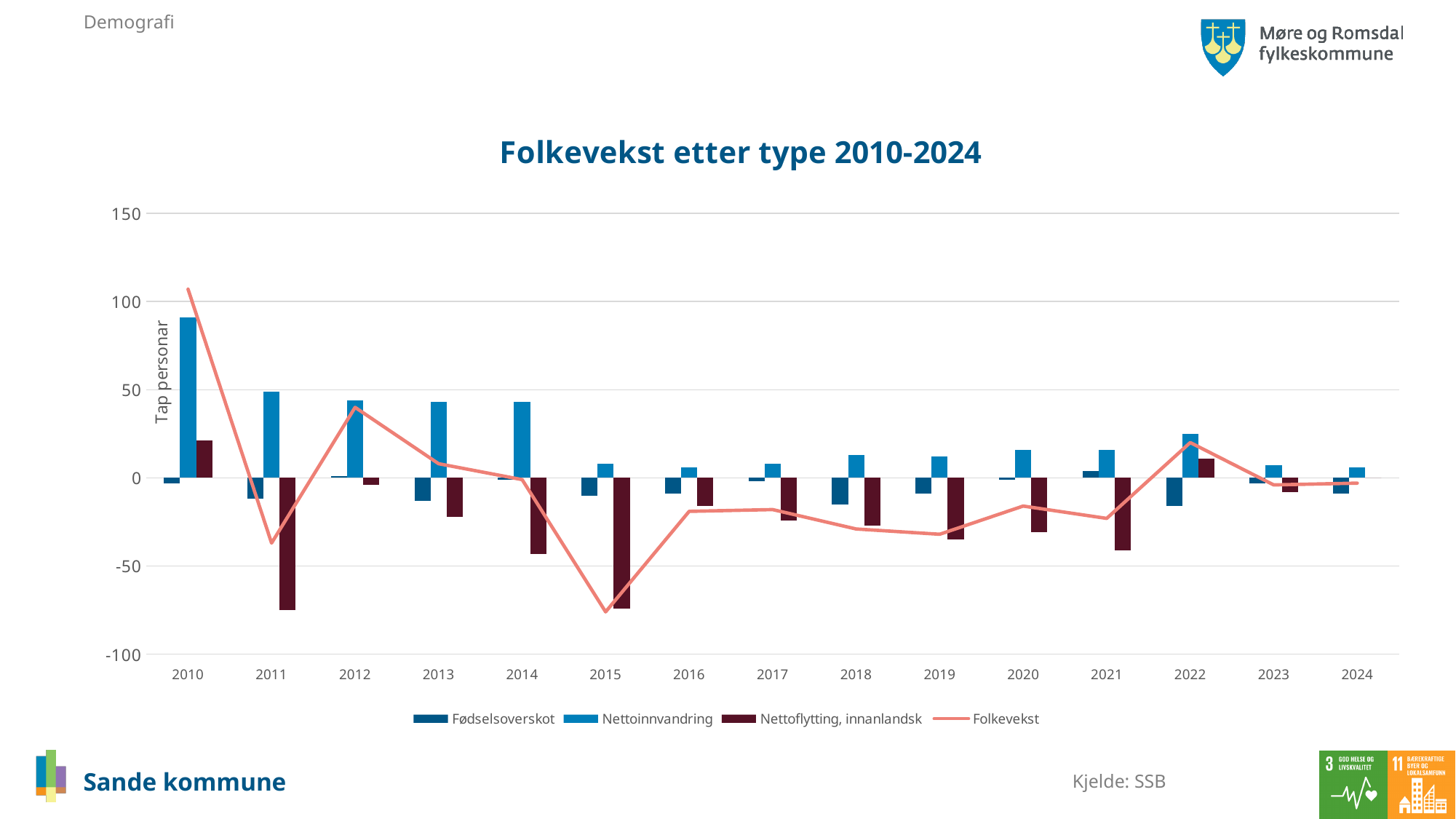
Which is larger, Nettoinnvandring in 2011 or Nettoinnvandring in 2022? 2011 Which series is drawn as a line rather than bars? Folkevekst In which year is Nettoinnvandring highest? 2010 In which year does the Folkevekst line reach its highest value? 2010 How many years are shown on the x axis? 15 How many series does the legend list? 4 What kind of chart is shown on the slide? bar chart with a line Does the Folkevekst line rise or fall from 2010 to 2011? fall In which year does the Folkevekst line reach its lowest value? 2015 Is the value for Folkevekst in 2010 greater or less than 100? greater Is the value for Nettoflytting, innanlandsk in 2011 greater or less than -50? less Is the value for Nettoinnvandring in 2010 greater or less than 50? greater